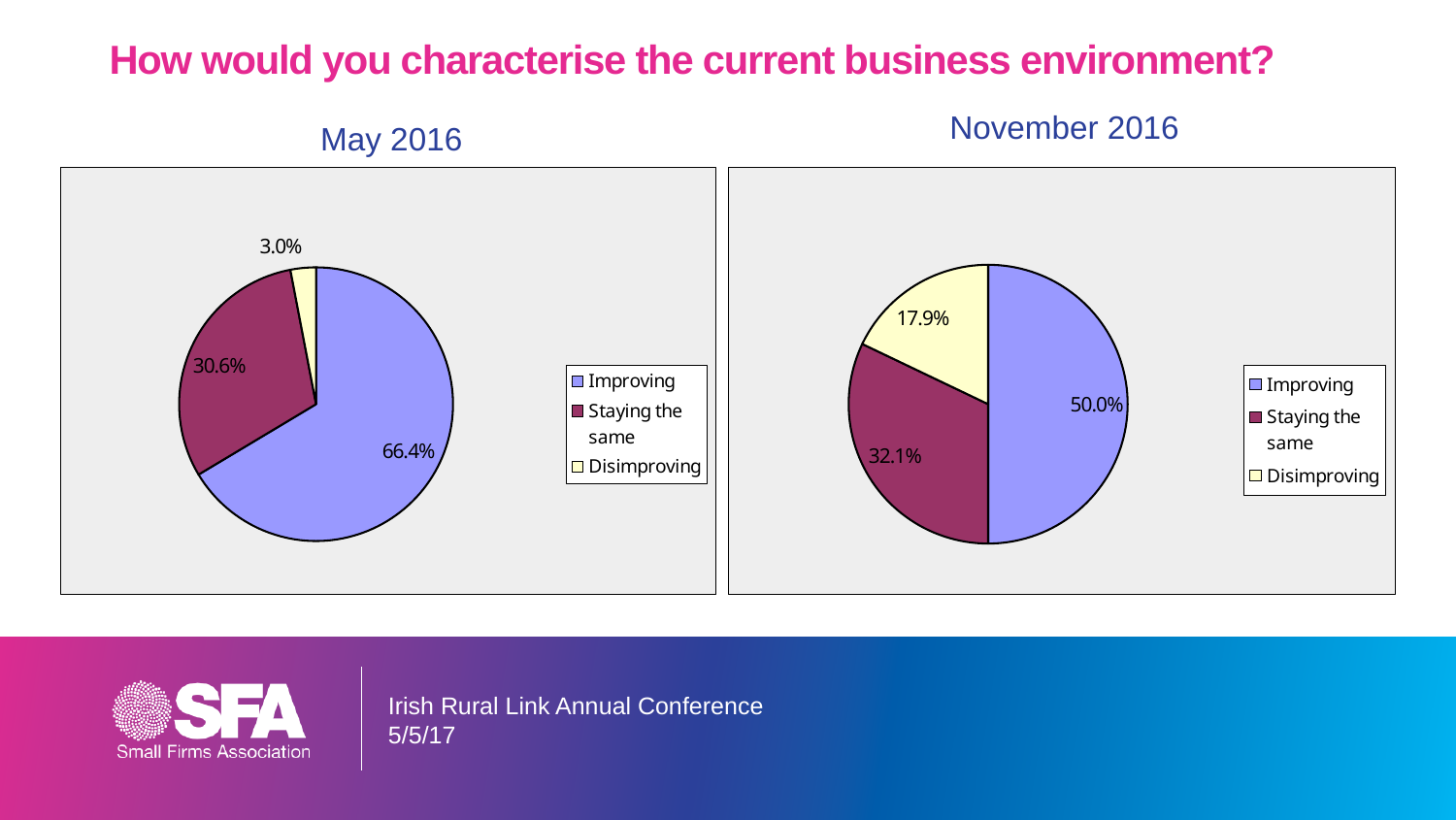
In the November 2016 chart, what colour is the Improving slice? Blue In the November 2016 chart, what share of respondents said the business environment is Disimproving? 17.9% In the May 2016 chart, which category has the largest slice? Improving In the November 2016 chart, what is the difference between the Staying the same share and the Disimproving share? 14.2% In the May 2016 chart, what share of respondents said the business environment is Disimproving? 3.0% In the November 2016 chart, which category has the smallest slice? Disimproving Which is larger: the Staying the same share in May 2016 or the Staying the same share in November 2016? November 2016 What kind of chart is used for the November 2016 data? Pie chart In the May 2016 chart, what share of respondents said the business environment is Improving? 66.4% How many categories does the May 2016 pie chart show? 3 In the November 2016 chart, what share of respondents said the business environment is Staying the same? 32.1% What is the difference between the Improving share in May 2016 and the Improving share in November 2016? 16.4%